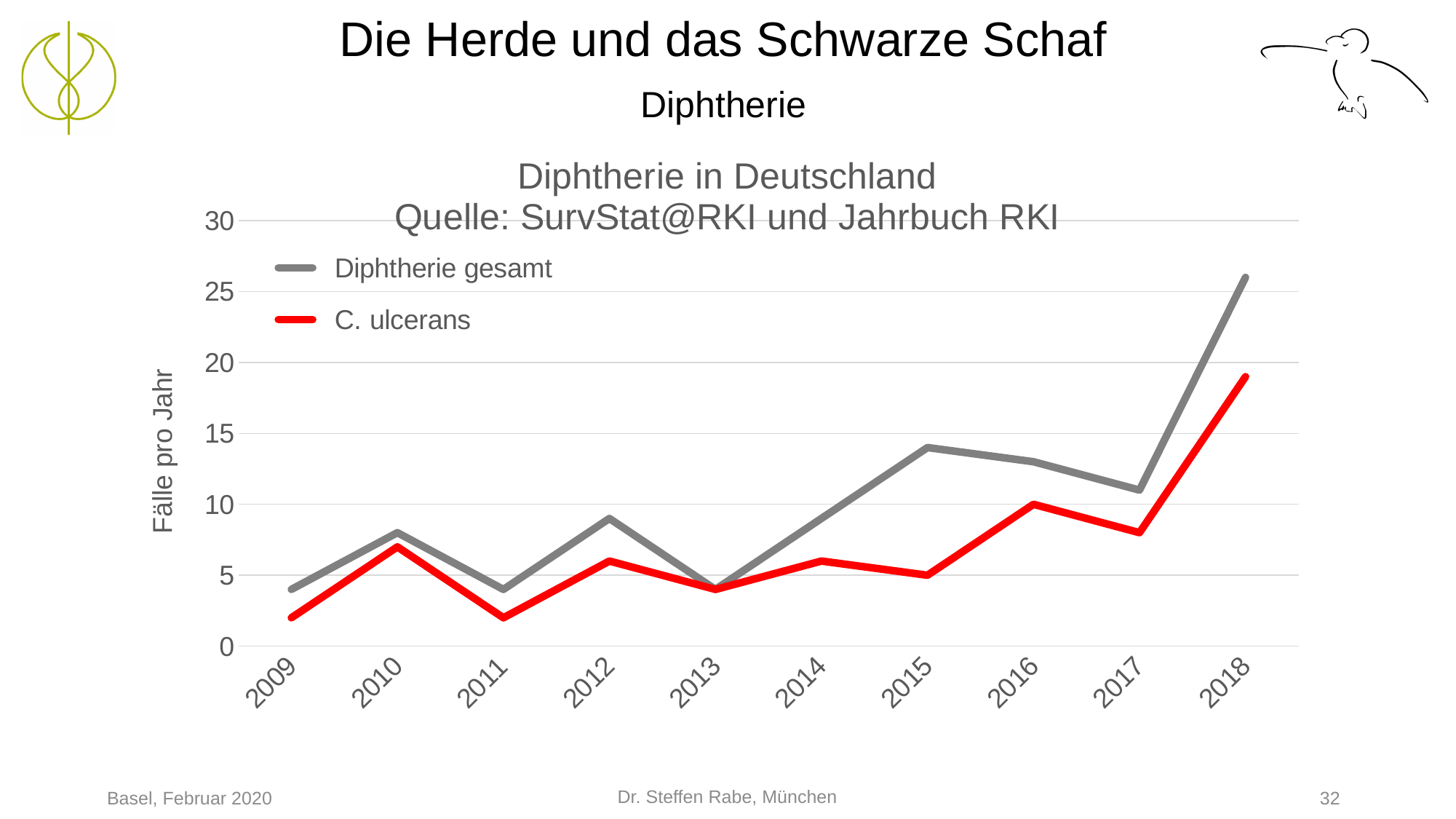
How many series does the legend list? 2 Is the value for C. ulcerans in 2018 greater or less than 20? less Is the value for Diphtherie gesamt in 2018 greater or less than 25? greater Which year has the highest value for Diphtherie gesamt? 2018 Is the value for Diphtherie gesamt in 2009 greater or less than 5? less How many years are plotted along the x axis? 10 Which is larger in 2012: Diphtherie gesamt or C. ulcerans? Diphtherie gesamt Do the values for Diphtherie gesamt rise or fall from 2017 to 2018? rise What is the label on the y axis? Fälle pro Jahr Which year has the highest value for C. ulcerans? 2018 What is the value for C. ulcerans in 2016? 10 What kind of chart is shown on the slide? line chart